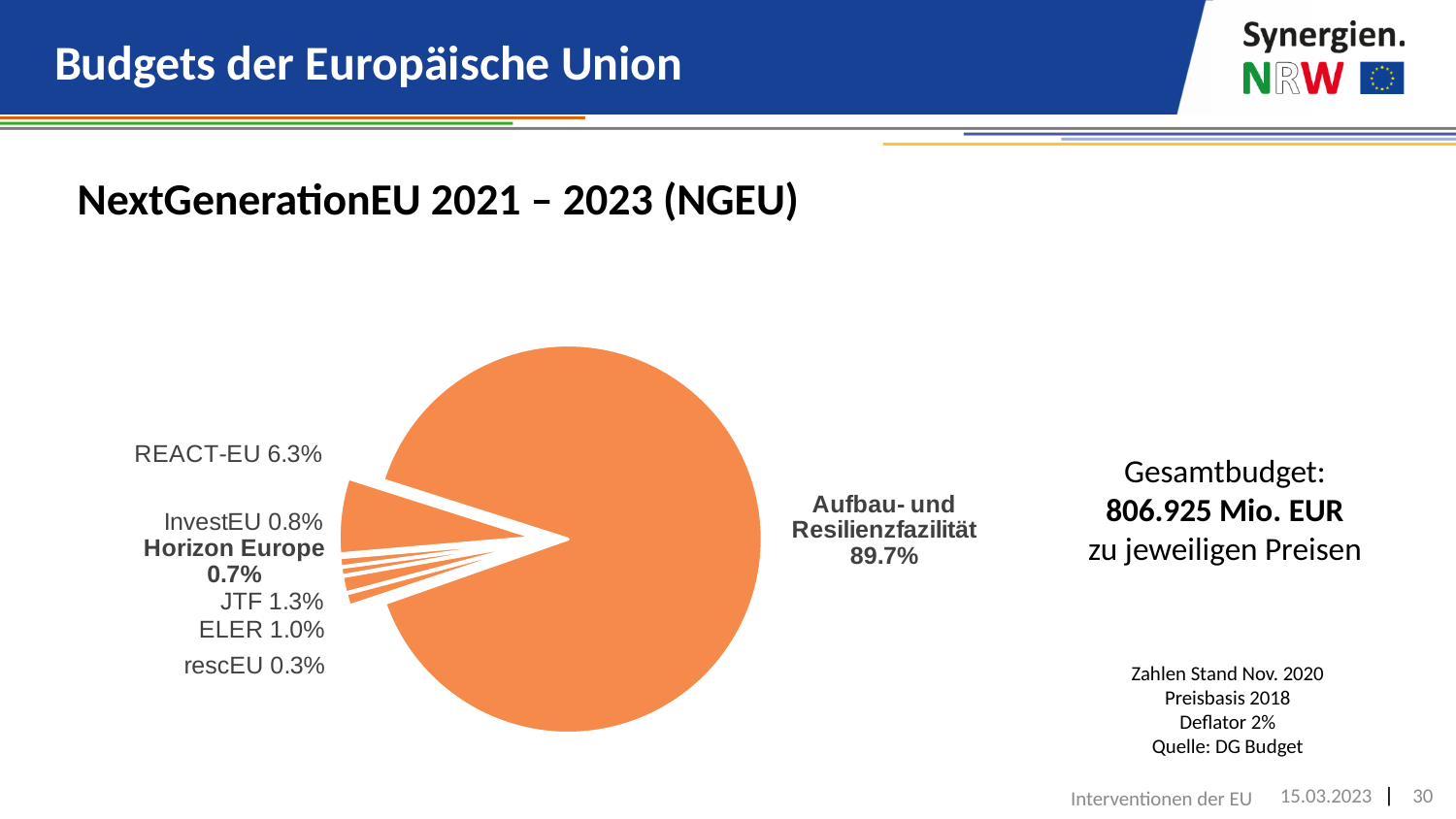
Which slice of the pie is the smallest? rescEU What is the value shown for JTF? 1.3% What is the value shown for Horizon Europe? 0.7% What is the value shown for rescEU? 0.3% How many slices does the pie chart have? 7 What kind of chart is shown on the slide? pie chart What share of the pie does REACT-EU have? 6.3% Which is larger, the share of InvestEU or the share of ELER? ELER What share of the pie does Aufbau- und Resilienzfazilität have? 89.7% What is the value shown for ELER? 1.0% What is the difference between the shares of REACT-EU and JTF? 5.0% Which slice of the pie is the largest? Aufbau- und Resilienzfazilität